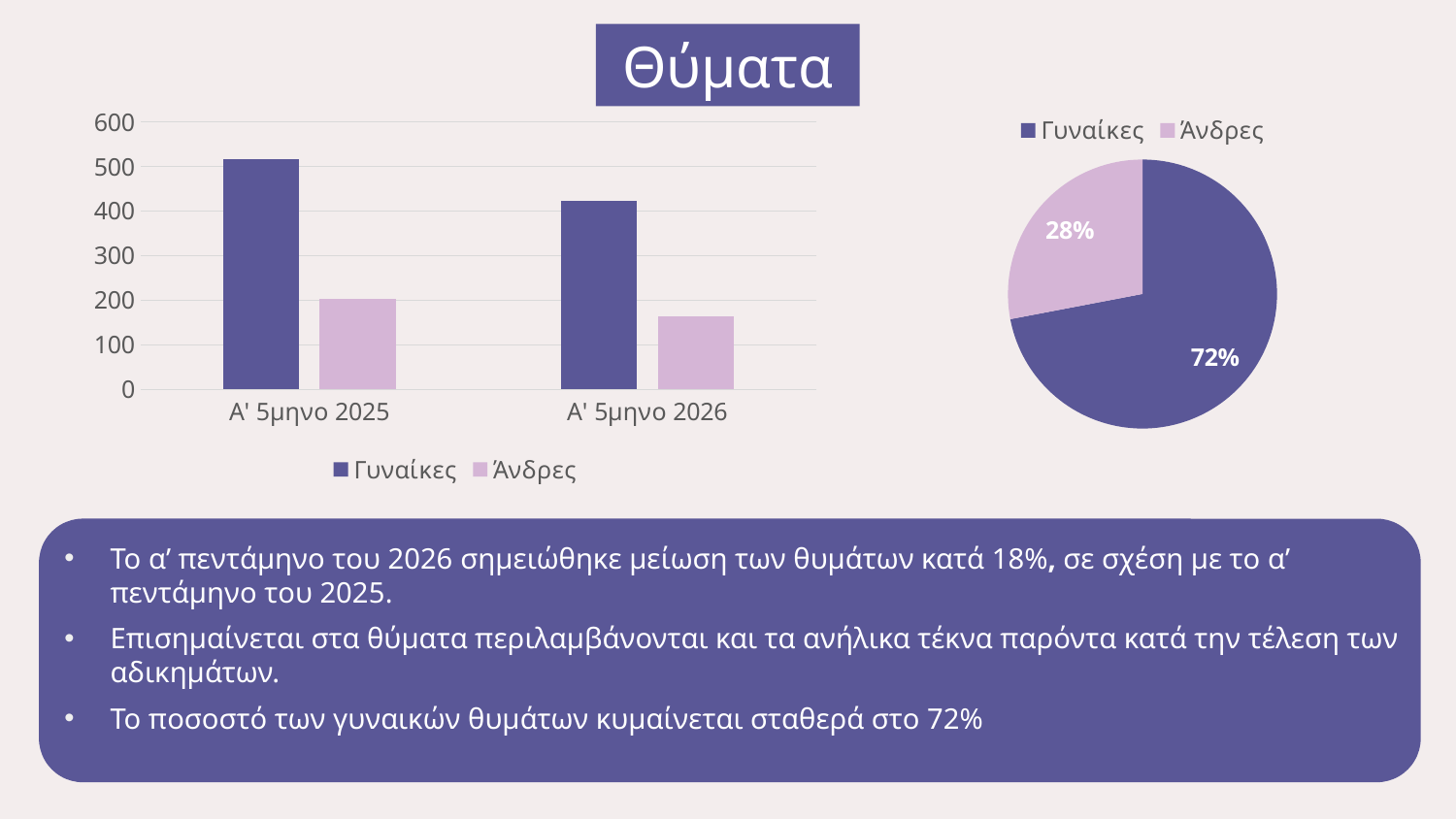
In the pie chart on the right, what share does Γυναίκες have? 72% In the bar chart on the left, is the value for Άνδρες in Α' 5μηνο 2026 greater or less than 200? less In the bar chart on the left, which category has the higher value for Γυναίκες, Α' 5μηνο 2025 or Α' 5μηνο 2026? Α' 5μηνο 2025 In the bar chart on the left, how many categories are shown on the x axis? 2 What kind of chart is the chart on the right of the slide? pie chart In the bar chart on the left, how many series does the legend list? 2 In the pie chart on the right, what share does Άνδρες have? 28% What is the title shown at the top of the slide? Θύματα In the bar chart on the left, is the value for Γυναίκες in Α' 5μηνο 2026 greater or less than 400? greater In the bar chart on the left, is the value for Γυναίκες in Α' 5μηνο 2025 greater or less than 500? greater What kind of chart is the chart on the left of the slide? bar chart In the bar chart on the left, do the values for Άνδρες rise or fall from Α' 5μηνο 2025 to Α' 5μηνο 2026? fall